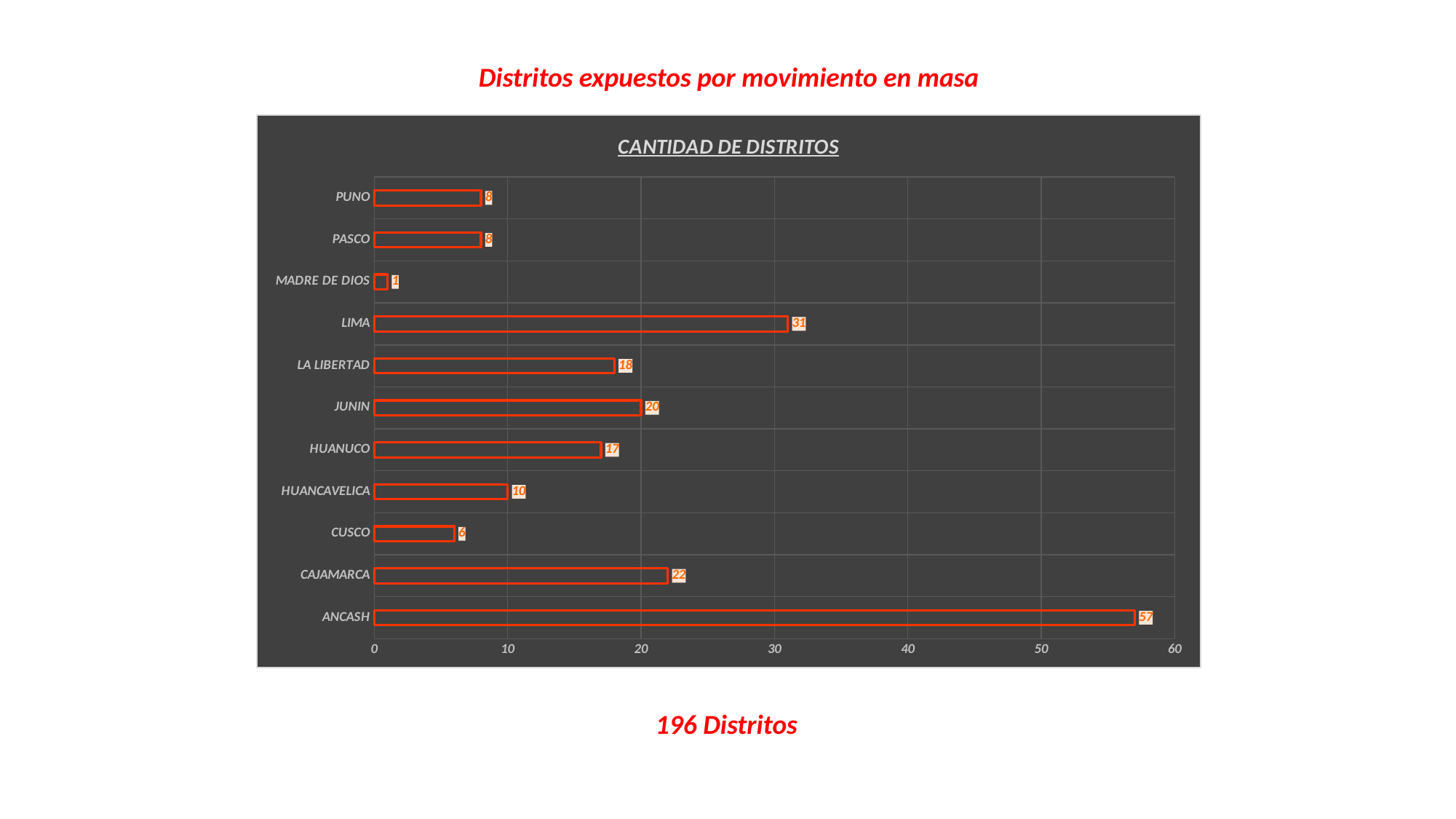
Which category has the highest value? ANCASH Which is larger, the value for JUNIN or the value for LA LIBERTAD? JUNIN Which category has the lowest value? MADRE DE DIOS How many categories are shown in the chart? 11 What is the title of the chart? CANTIDAD DE DISTRITOS What kind of chart is shown? bar chart What is the difference between the values for CUSCO and HUANCAVELICA? 4 What is the value for CAJAMARCA? 22 Is the value for HUANUCO greater or less than 20? less What is the value for LIMA? 31 What is the difference between the values for ANCASH and LIMA? 26 What is the value for MADRE DE DIOS? 1